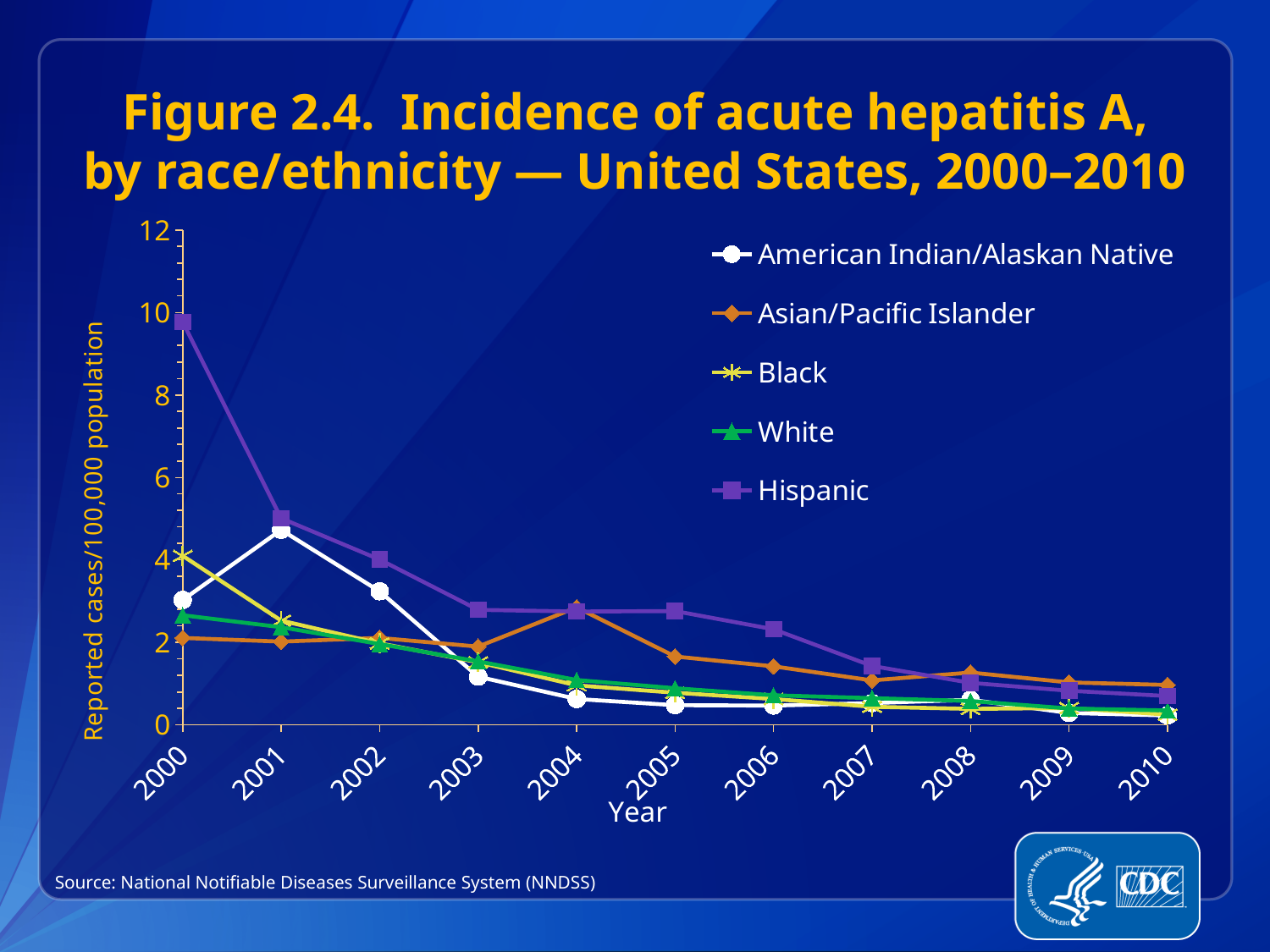
What kind of chart is shown on the slide? line chart Which race/ethnicity group had the highest incidence in 2000? Hispanic How many years are plotted along the x axis? 11 Is the value for American Indian/Alaskan Native in 2004 greater or less than 2? less Which race/ethnicity group had the highest incidence in 2006? Hispanic What is the title of the y axis? Reported cases/100,000 population In 2001, which is larger: the value for American Indian/Alaskan Native or the value for Black? American Indian/Alaskan Native Is the value for Black in 2000 greater or less than 2? greater Is the value for Hispanic in 2000 greater or less than 8? greater Does the Hispanic line rise or fall from 2000 to 2010? fall How many series does the legend list? 5